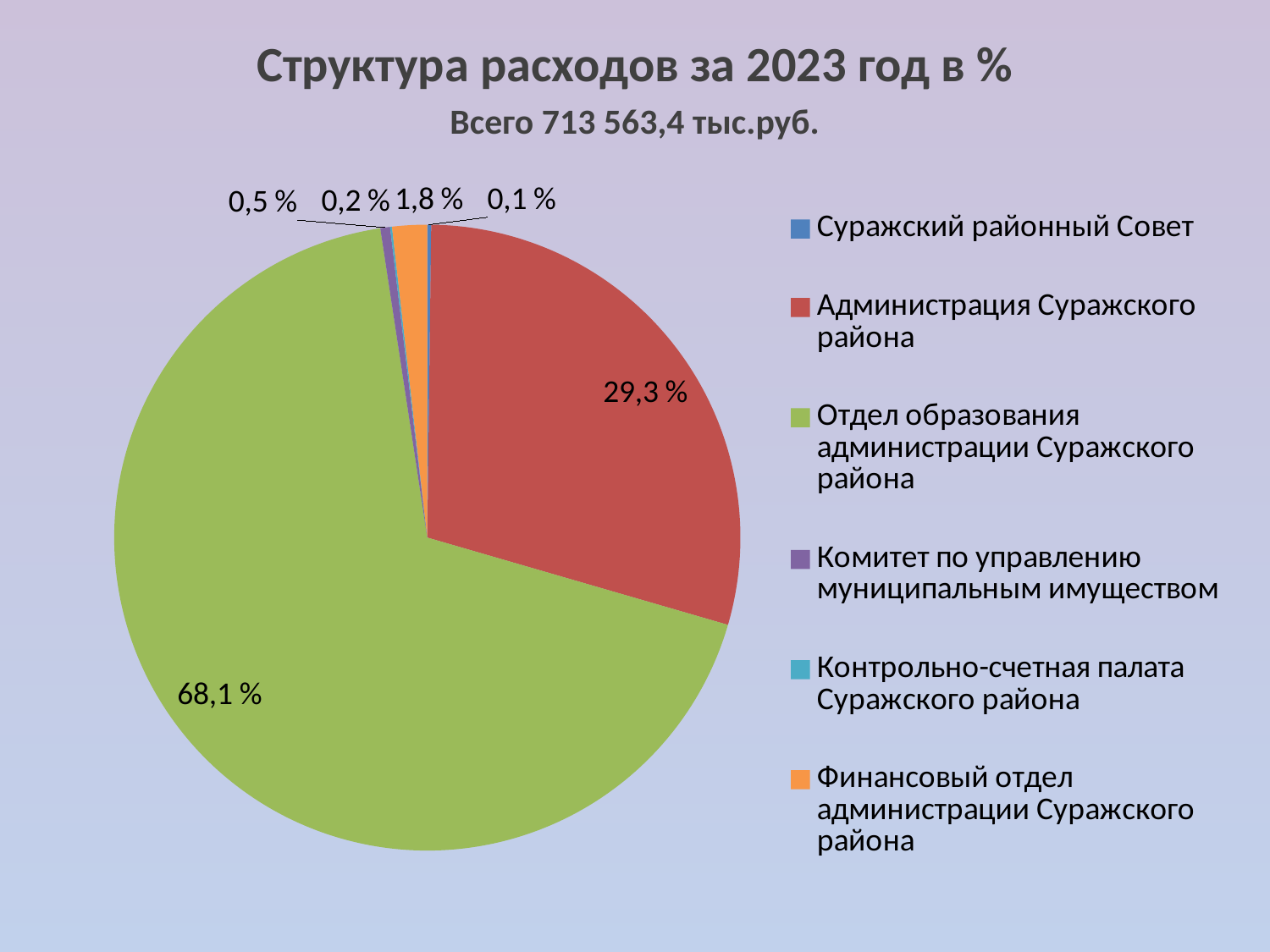
What total amount of expenses is stated under the chart title? 713 563,4 тыс.руб. What is the title of the chart? Структура расходов за 2023 год в % Which is larger: the share of Администрация Суражского района or the share of Финансовый отдел? Администрация Суражского района What share of expenses does Финансовый отдел администрации Суражского района account for? 1,8 % What kind of chart is shown on the slide? pie chart What share of expenses does Администрация Суражского района account for? 29,3 % Which category has the largest share of expenses? Отдел образования администрации Суражского района What is the smallest share printed on the pie chart? 0,1 % How many categories does the legend list? 6 What share of expenses does Отдел образования администрации Суражского района account for? 68,1 % By how many percentage points does the share of Отдел образования exceed the share of Администрация Суражского района? 38,8